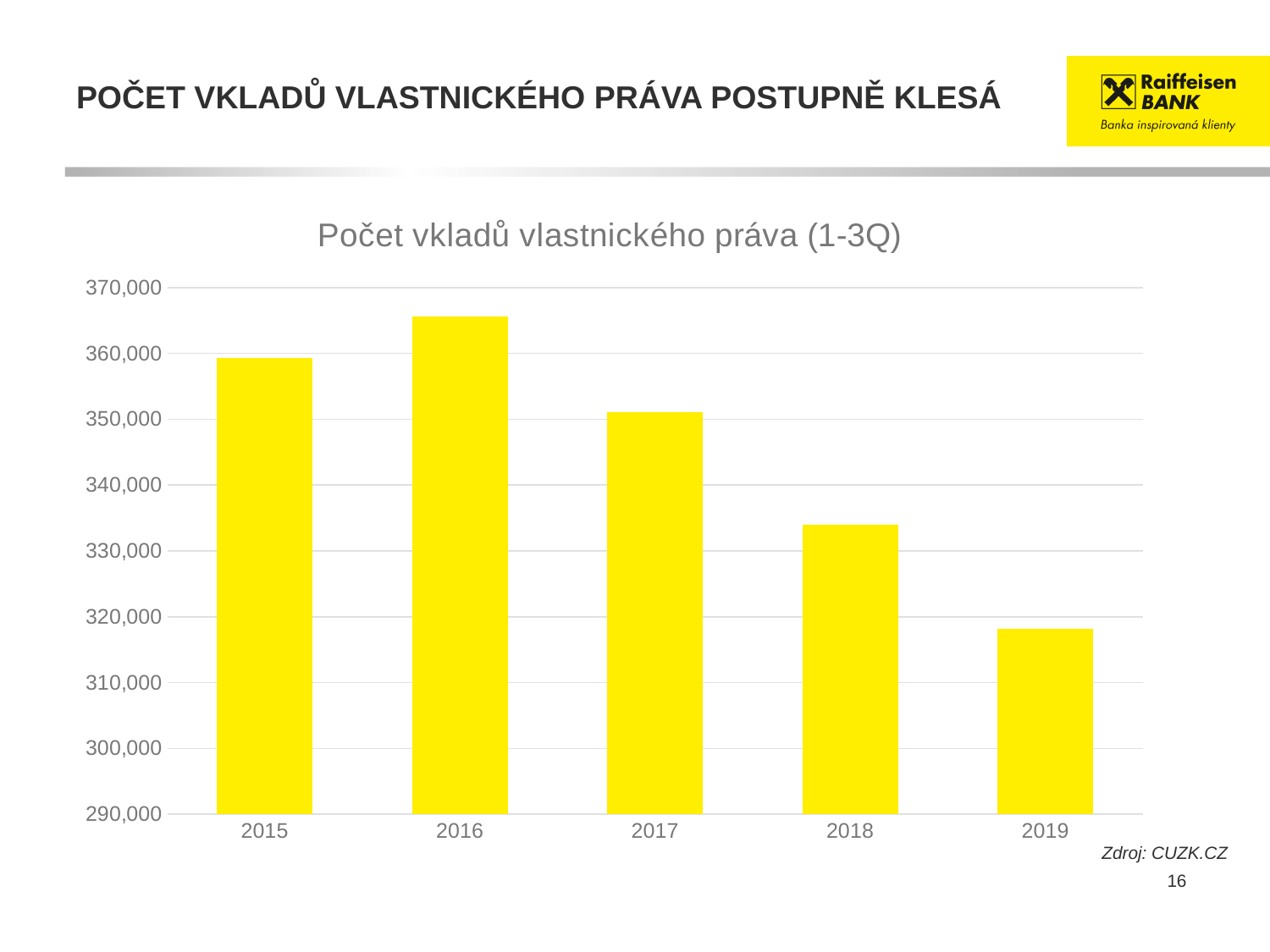
Which year has the lowest bar in the chart? 2019 How many years are shown on the x axis of the chart? 5 Is the value for 2016 greater or less than 360,000? greater Which is larger, the value for 2015 or the value for 2017? 2015 Which is larger, the value for 2018 or the value for 2019? 2018 What is the title of the chart? Počet vkladů vlastnického práva (1-3Q) From 2016 to 2019, do the values rise or fall? fall Is the value for 2018 greater or less than 330,000? greater Is the value for 2017 greater or less than 360,000? less What kind of chart is shown on the slide? bar chart Which year has the highest bar in the chart? 2016